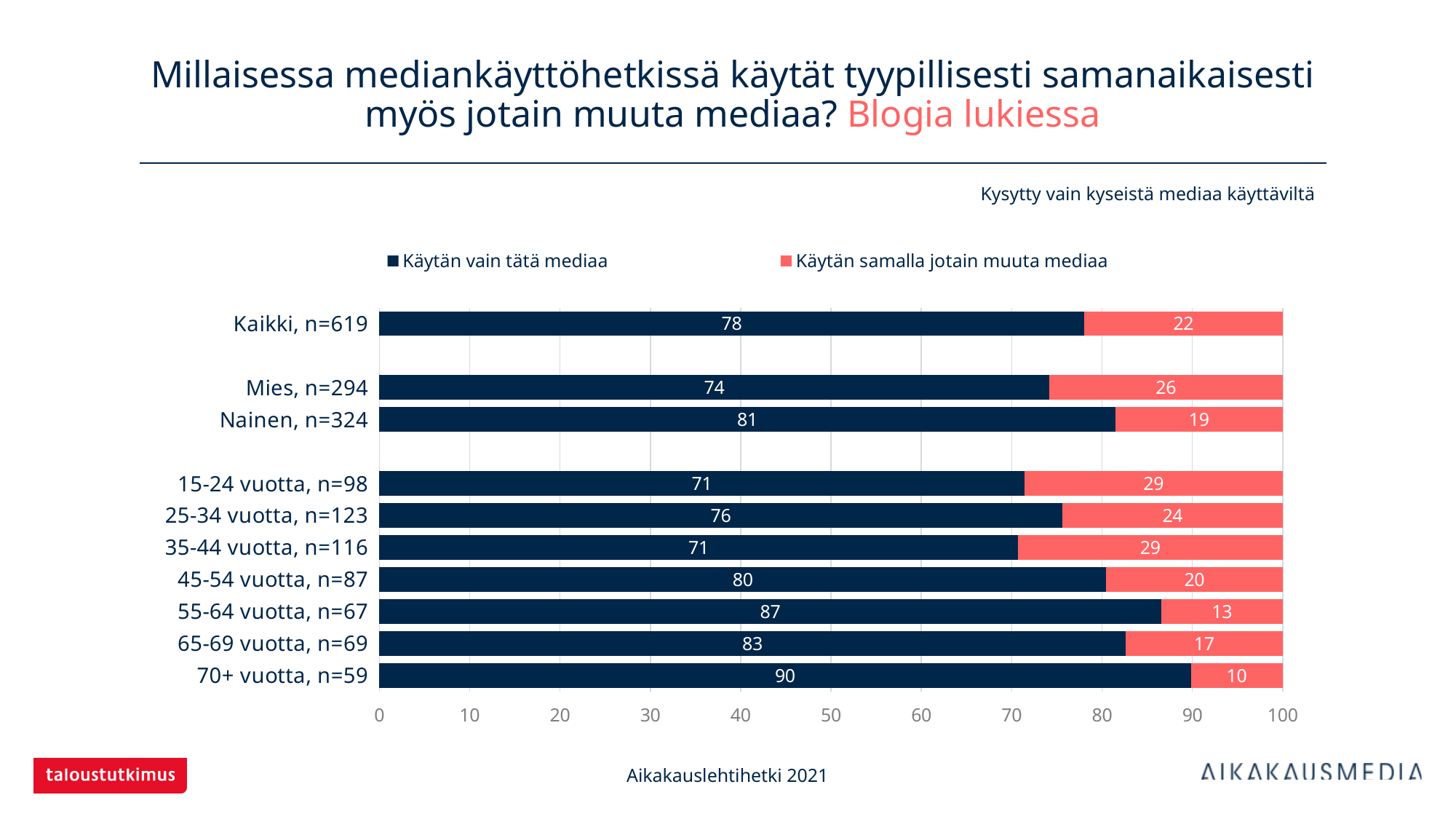
What kind of chart is shown on the slide? Stacked bar chart Which category has the highest value for "Käytän vain tätä mediaa"? 70+ vuotta, n=59 What is the value of "Käytän vain tätä mediaa" for 55-64 vuotta, n=67? 87 What is the total of the stacked bar for 65-69 vuotta, n=69? 100 Which has a larger "Käytän samalla jotain muuta mediaa" value: 15-24 vuotta, n=98 or 45-54 vuotta, n=87? 15-24 vuotta, n=98 How many series does the legend list? 2 Which category has the lowest value for "Käytän samalla jotain muuta mediaa"? 70+ vuotta, n=59 How many categories are shown on the chart? 10 What is the value of "Käytän samalla jotain muuta mediaa" for Mies, n=294? 26 What is the difference between the "Käytän vain tätä mediaa" values for Nainen, n=324 and Mies, n=294? 7 What is the maximum value shown on the x axis? 100 What is the value of "Käytän vain tätä mediaa" for Kaikki, n=619? 78